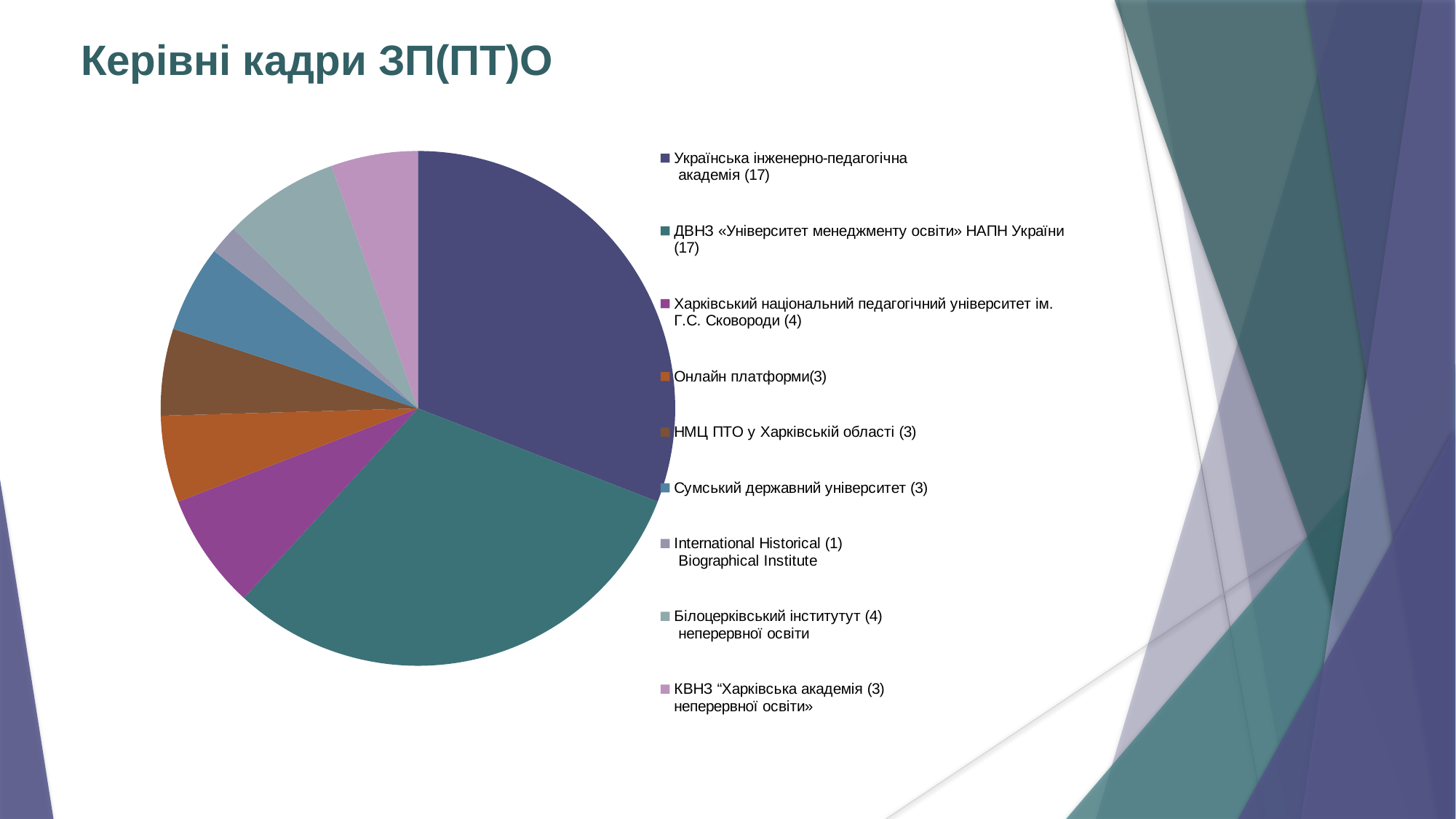
What is the value for Онлайн платформи? 3 What is the value for International Historical Biographical Institute? 1 What is the difference between the values for НМЦ ПТО у Харківській області and International Historical Biographical Institute? 2 What is the value for Харківський національний педагогічний університет ім. Г.С. Сковороди? 4 What is the value for ДВНЗ «Університет менеджменту освіти» НАПН України? 17 Which is larger: the value for Білоцерківський інститутут неперервної освіти or the value for Сумський державний університет? Білоцерківський інститутут неперервної освіти How many categories does the pie chart have? 9 What is the title of the chart on the slide? Керівні кадри ЗП(ПТ)О What is the value for Українська інженерно-педагогічна академія? 17 Which category has the smallest slice of the pie? International Historical Biographical Institute What is the difference between the values for Українська інженерно-педагогічна академія and Білоцерківський інститутут неперервної освіти? 13 What kind of chart is shown on the slide? pie chart